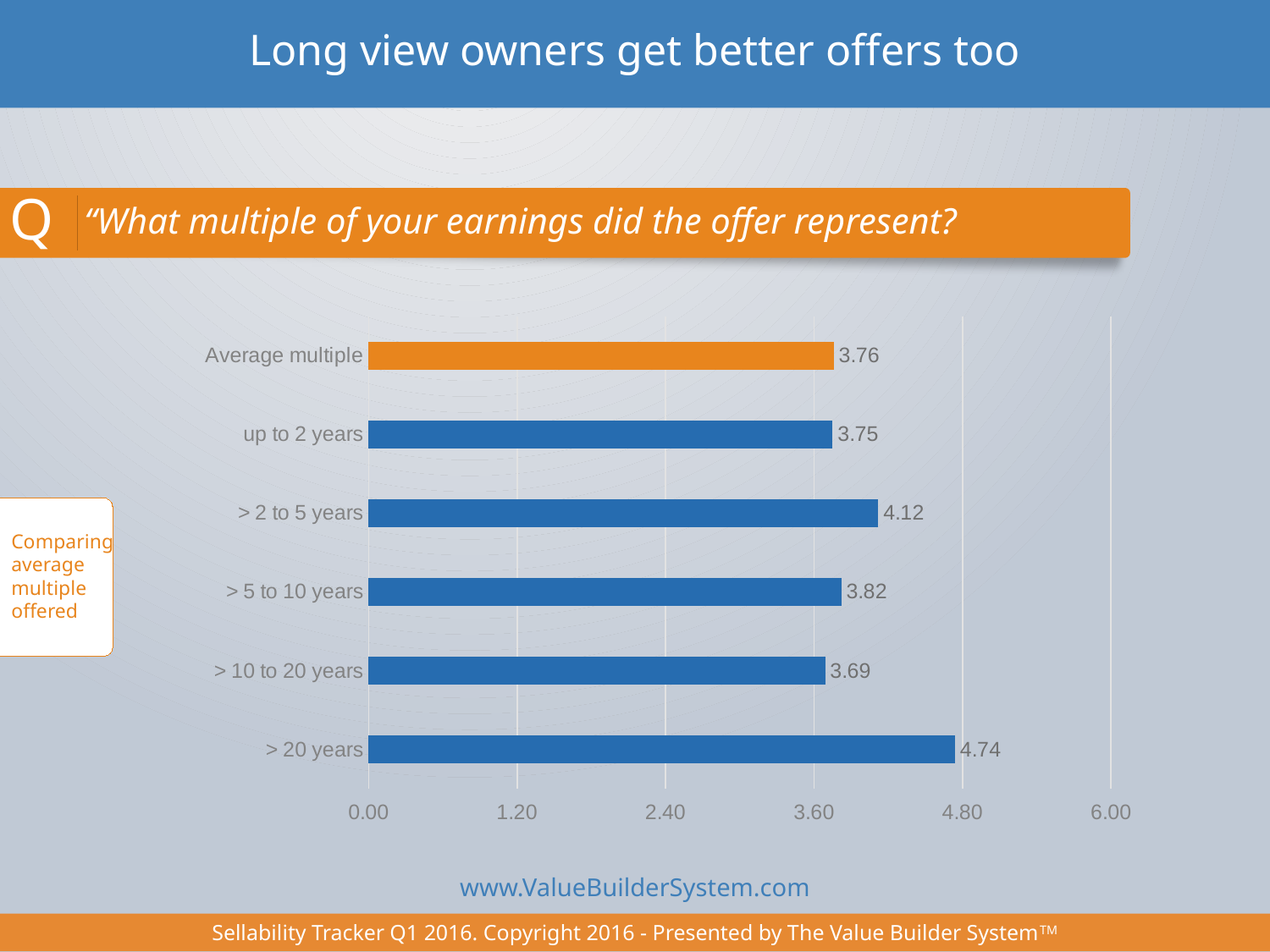
Which is larger, the value for "> 5 to 10 years" or "> 10 to 20 years"? > 5 to 10 years What is the value for "Average multiple"? 3.76 What is the value for "> 20 years"? 4.74 What is the value for "> 10 to 20 years"? 3.69 How many categories are shown in the chart? 6 What kind of chart is shown on the slide? bar chart Which category has the lowest value? > 10 to 20 years Is the value for "> 20 years" greater or less than 4.80? less Which category has the highest value? > 20 years Which bar is coloured orange rather than blue? Average multiple What is the difference between the values for "> 20 years" and "> 2 to 5 years"? 0.62 What is the value for "> 2 to 5 years"? 4.12